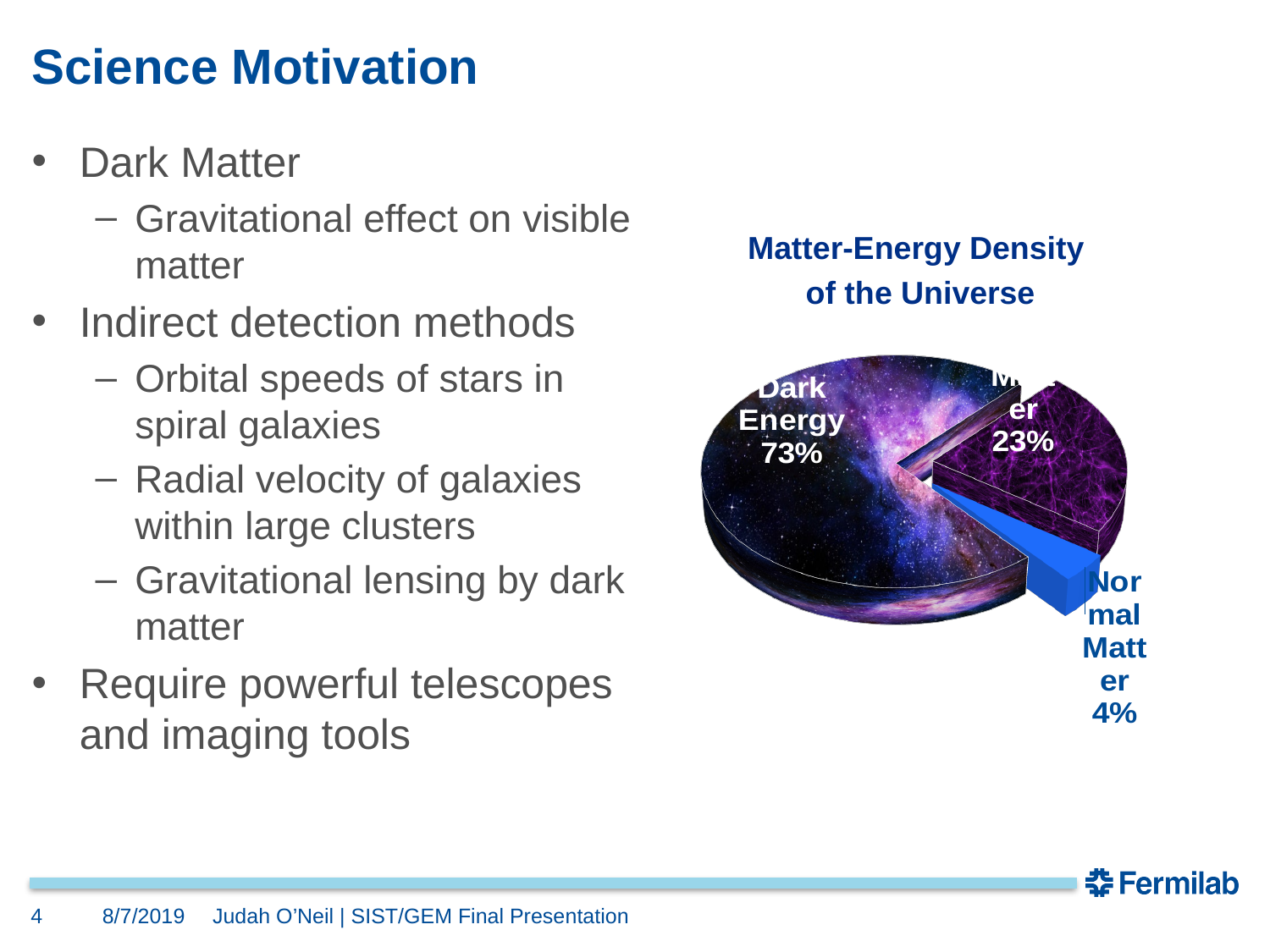
What is the difference in percentage points between the Dark Energy slice and the Normal Matter slice? 69 What is the title of the chart on the slide? Matter-Energy Density of the Universe What is the difference in percentage points between the Dark Energy slice and the 23% slice? 50 What percentage is shown on the slice between the Dark Energy and Normal Matter slices? 23% What share of the pie does Normal Matter take? 4% What colour is the Normal Matter slice of the pie? blue Which is larger, the Dark Energy slice or the Normal Matter slice? Dark Energy What share of the pie does Dark Energy take? 73% Which slice of the pie is the largest? Dark Energy Which slice of the pie is the smallest? Normal Matter What kind of chart is shown on the slide? pie chart How many slices does the pie chart have? 3